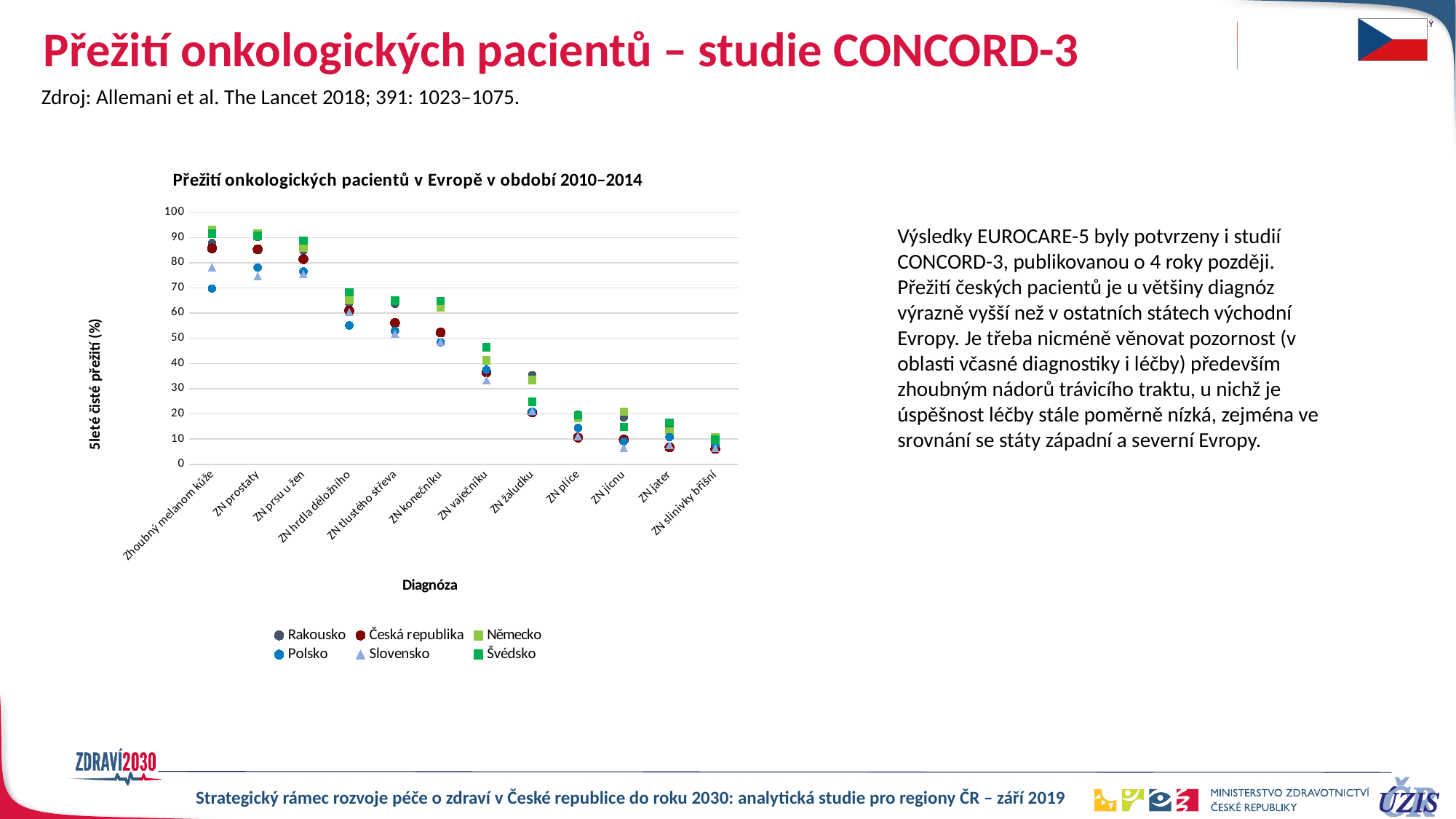
Is the value for Švédsko for ZN vaječníku greater or less than 40? greater Do the survival values generally rise or fall moving from left to right along the x axis? fall Which diagnosis has the highest 5-year survival values in the chart? Zhoubný melanom kůže Is the value for Slovensko for ZN jícnu greater or less than 10? less What is the label of the vertical axis of the chart? 5leté čisté přežití (%) For ZN hrdla děložního, which is larger: the value for Česká republika or for Polsko? Česká republika How many diagnoses are plotted along the x axis of the chart? 12 Is the value for Česká republika for ZN prostaty greater or less than 80? greater How many countries (series) does the chart legend list? 6 Which country has the lowest value for Zhoubný melanom kůže? Polsko What kind of chart is shown on the slide? scatter chart Which diagnosis has the lowest 5-year survival values in the chart? ZN slinivky břišní